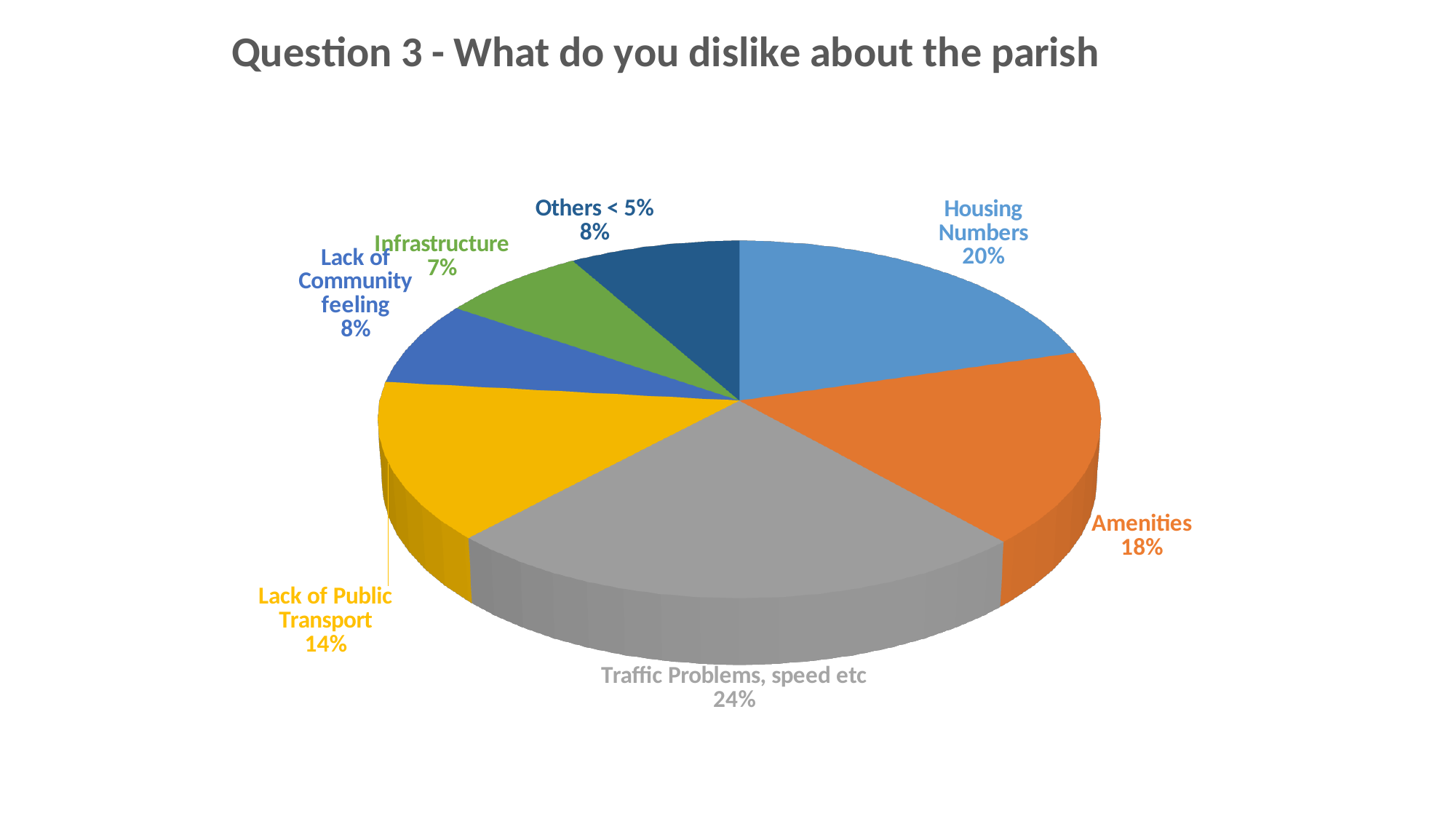
What percentage of responses is for Lack of Public Transport? 14% What percentage of responses is for Infrastructure? 7% What colour is the Lack of Public Transport slice? Yellow Which is larger, the share for Lack of Public Transport or the share for Amenities? Amenities Which category has the smallest share of the pie? Infrastructure How many categories are shown in the pie chart? 7 What kind of chart is shown on the slide? Pie chart What percentage of responses is for Traffic Problems, speed etc? 24% What percentage of responses is for Housing Numbers? 20% What is the title of the chart? Question 3 - What do you dislike about the parish Which category has the largest share of the pie? Traffic Problems, speed etc What is the difference in percentage points between Housing Numbers and Amenities? 2